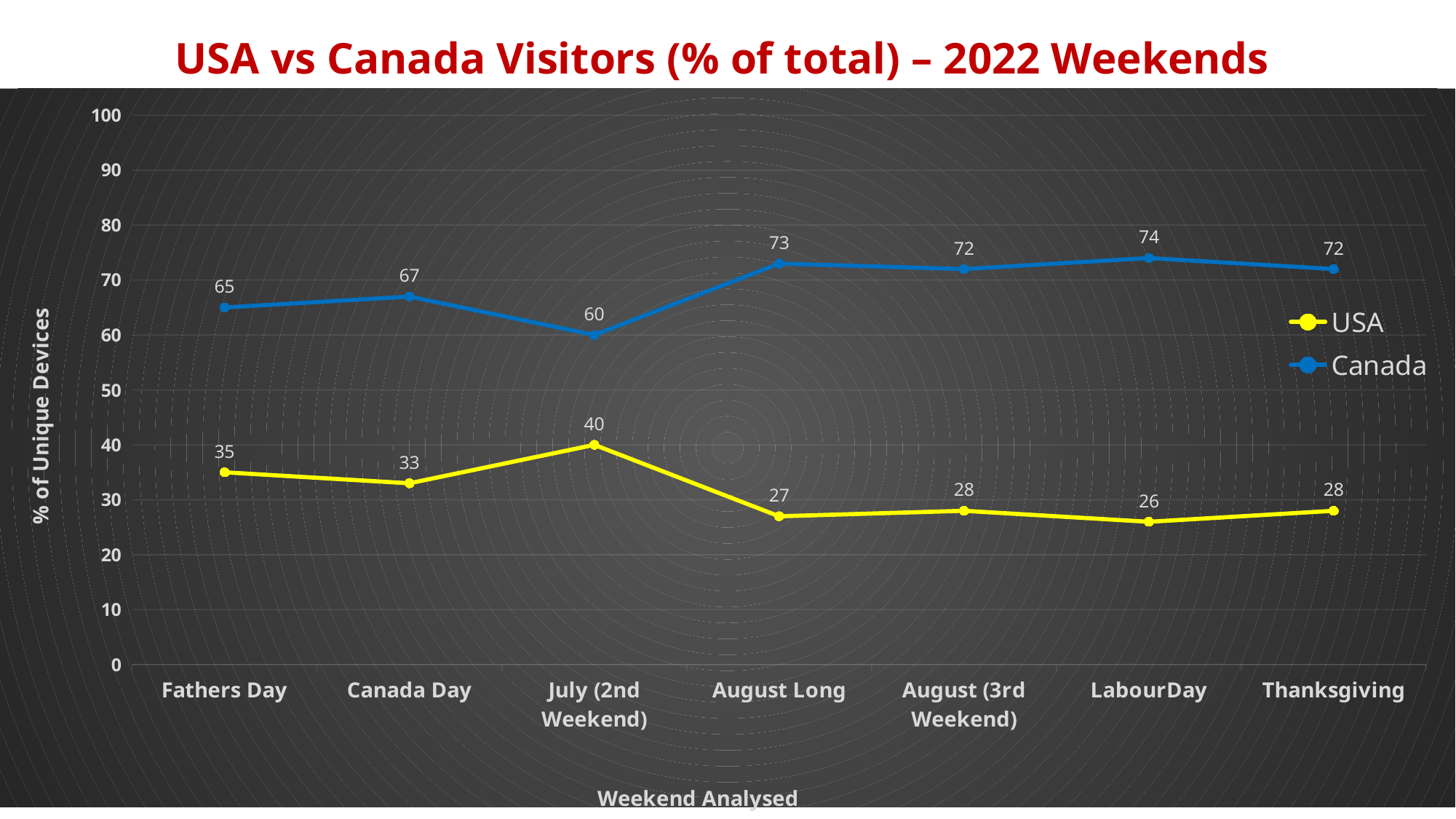
Is the Canada value for Fathers Day greater or less than 60? greater Which is larger, the USA value for July (2nd Weekend) or the USA value for Canada Day? July (2nd Weekend) What is the title of the chart? USA vs Canada Visitors (% of total) – 2022 Weekends Which weekend has the lowest USA value? LabourDay What is the Canada value for July (2nd Weekend)? 60 Which weekend has the highest Canada value? LabourDay What is the USA value for Fathers Day? 35 How many weekends are plotted on the x axis? 7 How many series does the legend list? 2 What is the difference between the Canada and USA values for August Long? 46 What kind of chart is shown on the slide? line chart What is the USA value for LabourDay? 26